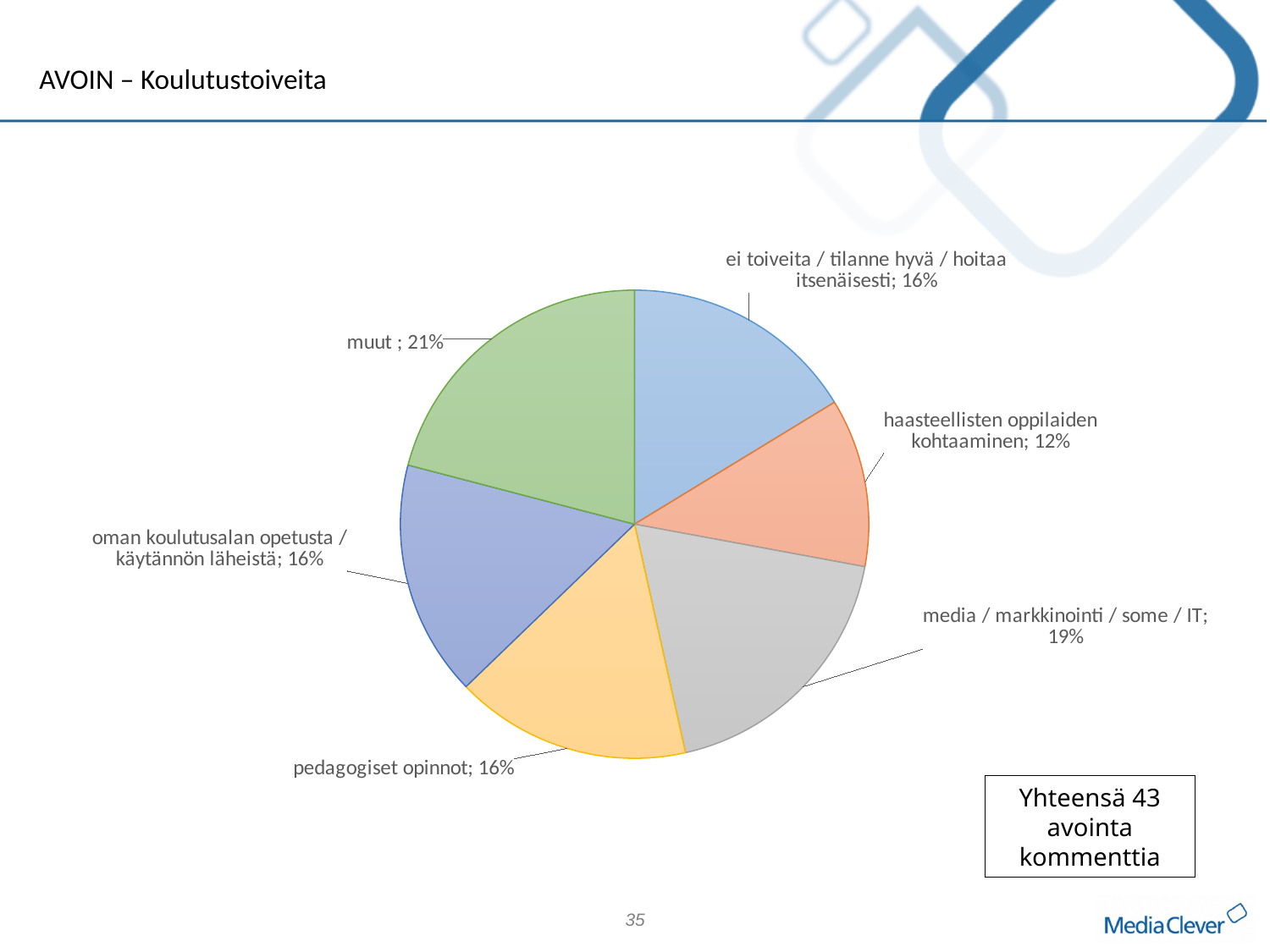
What share of the pie is 'haasteellisten oppilaiden kohtaaminen'? 12% What is the difference in percentage points between 'muut' and 'haasteellisten oppilaiden kohtaaminen'? 9 What share of the pie is 'media / markkinointi / some / IT'? 19% What share of the pie is 'muut'? 21% Which category has the smallest share of the pie? haasteellisten oppilaiden kohtaaminen What is the title of the slide containing the pie chart? AVOIN – Koulutustoiveita Which category has the largest share of the pie? muut What kind of chart is shown on the slide? pie chart How many slices does the pie chart have? 6 According to the text box on the slide, how many open comments were there in total? 43 Which is larger: the share for 'media / markkinointi / some / IT' or the share for 'pedagogiset opinnot'? media / markkinointi / some / IT